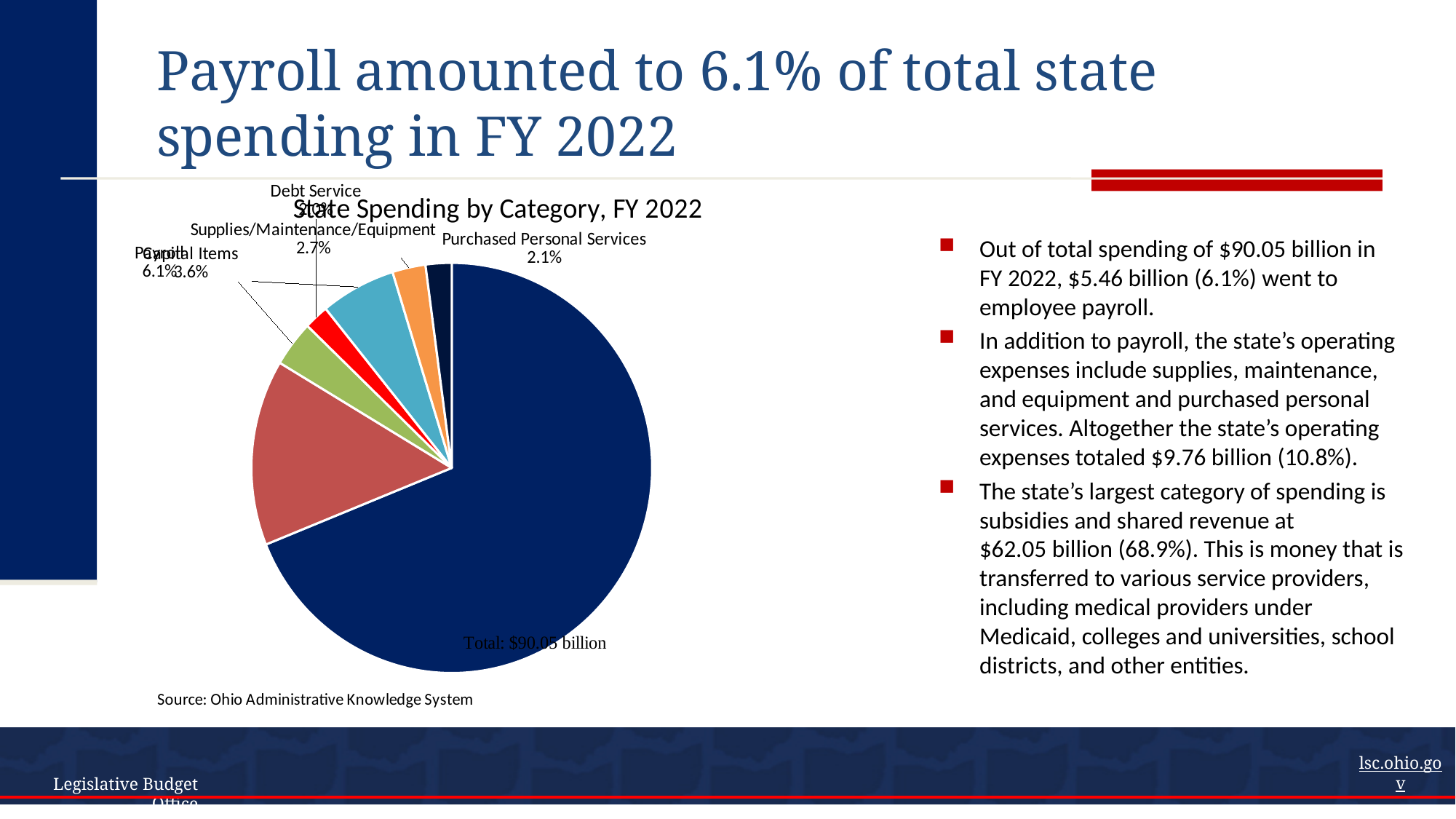
What is the difference in percentage points between the Supplies/Maintenance/Equipment slice and the Purchased Personal Services slice? 0.6 percentage points Which is larger, the Capital Items slice or the Supplies/Maintenance/Equipment slice? Capital Items What total amount is printed on the chart? Total: $90.05 billion What kind of chart is shown on the slide? Pie chart What share of state spending does the Capital Items slice represent? 3.6% What share of state spending does the Purchased Personal Services slice represent? 2.1% What is the difference in percentage points between the Payroll slice and the Capital Items slice? 2.5 percentage points What share of state spending does the Payroll slice represent? 6.1% How many slices does the pie chart have? 7 What is the title of the chart? State Spending by Category, FY 2022 What share of state spending does the Supplies/Maintenance/Equipment slice represent? 2.7% Which is larger, the Payroll slice or the Capital Items slice? Payroll